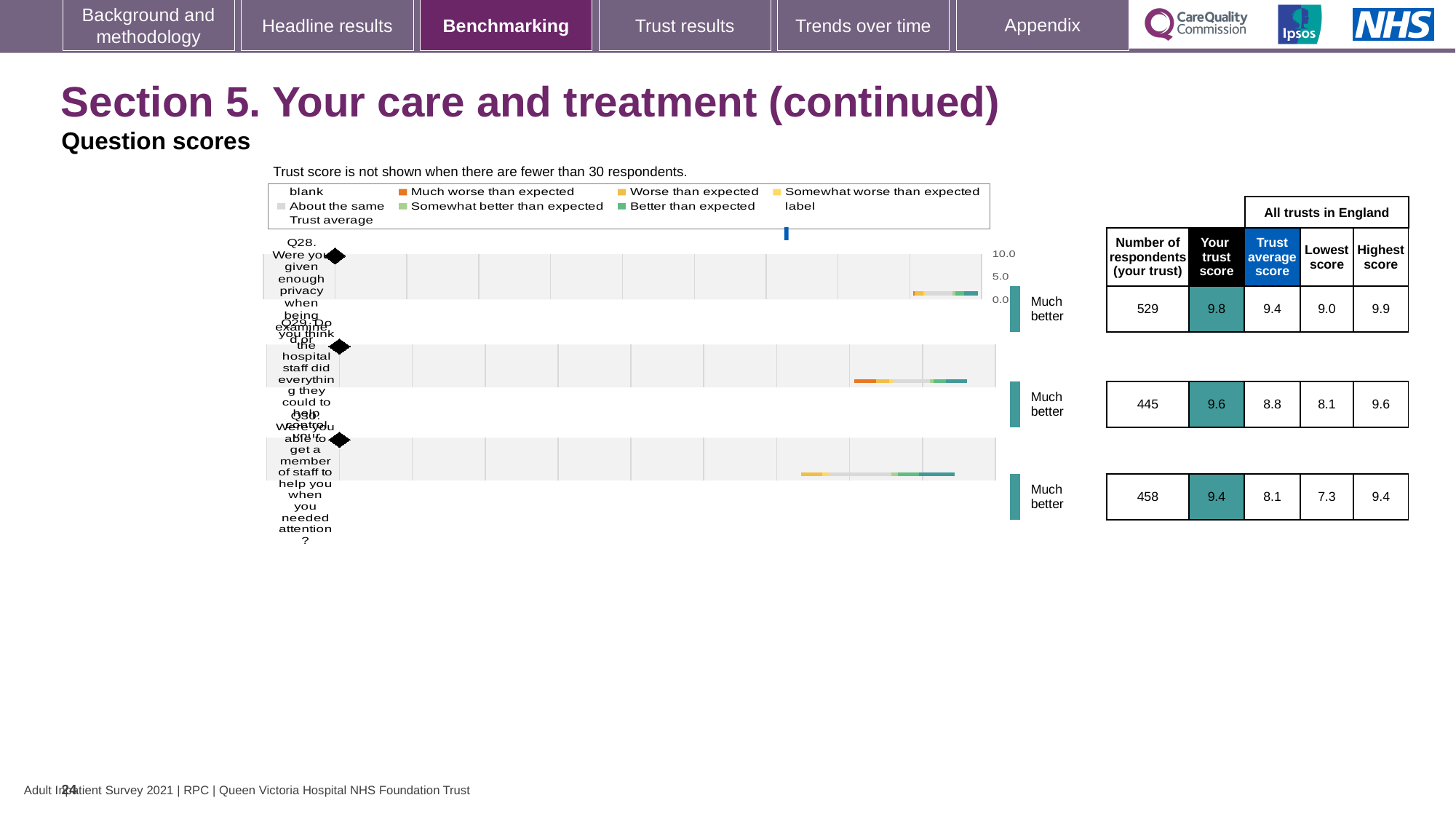
What is the trust average score for Q30 (Were you able to get a member of staff to help you when you needed attention)? 8.1 Which question has the highest 'Your trust score' on this slide? Q28 How many questions are shown on this slide? 3 How many respondents from your trust answered Q29 (Do you think the hospital staff did everything they could to help control your pain)? 445 What rating label is shown next to each of the three question charts? Much better What is the highest score across all trusts in England for Q30? 9.4 What is the difference between your trust score and the trust average score for Q29? 0.8 What is the maximum value shown on the chart axis? 10.0 Which is larger: the number of respondents for Q28 or for Q30? Q28 Which question has the lowest 'Lowest score' value across all trusts in England? Q30 What is the 'Your trust score' value for Q28 (Were you given enough privacy when being examined or treated)? 9.8 What kind of chart is used to show the benchmarking results for each question? Bar chart